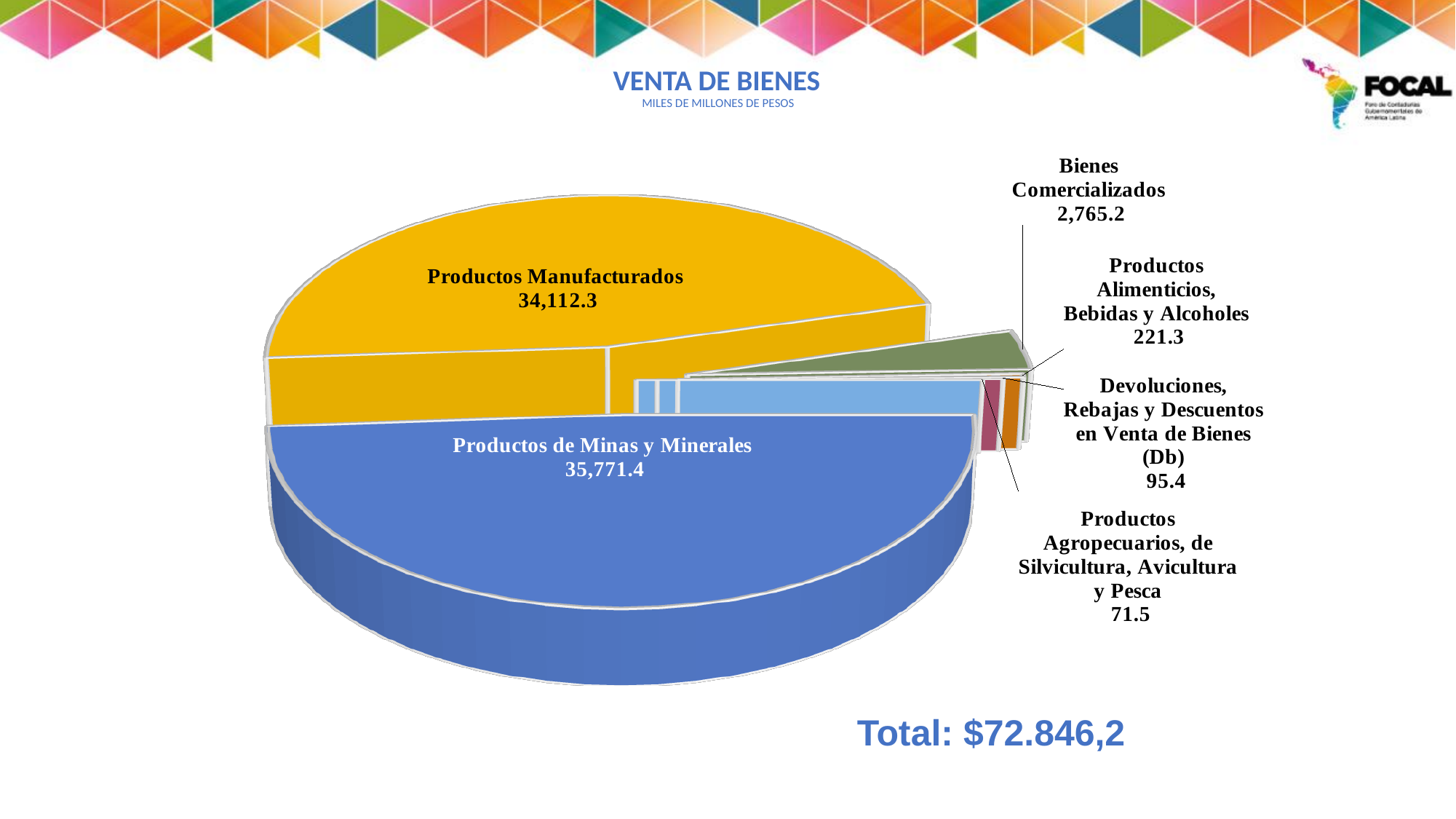
What is the value for Bienes Comercializados? 2,765.2 What is the value for Productos Manufacturados? 34,112.3 What is the value for Productos Alimenticios, Bebidas y Alcoholes? 221.3 What is the value for Productos de Minas y Minerales? 35,771.4 Which is larger, Bienes Comercializados or Productos Alimenticios, Bebidas y Alcoholes? Bienes Comercializados Which category has the smallest value? Productos Agropecuarios, de Silvicultura, Avicultura y Pesca What kind of chart is shown on the slide? Pie chart What is the difference between Productos de Minas y Minerales and Productos Manufacturados? 1,659.1 What is the title of the chart? VENTA DE BIENES Which category has the largest value? Productos de Minas y Minerales How many categories does the pie chart show? 6 What is the value for Productos Agropecuarios, de Silvicultura, Avicultura y Pesca? 71.5